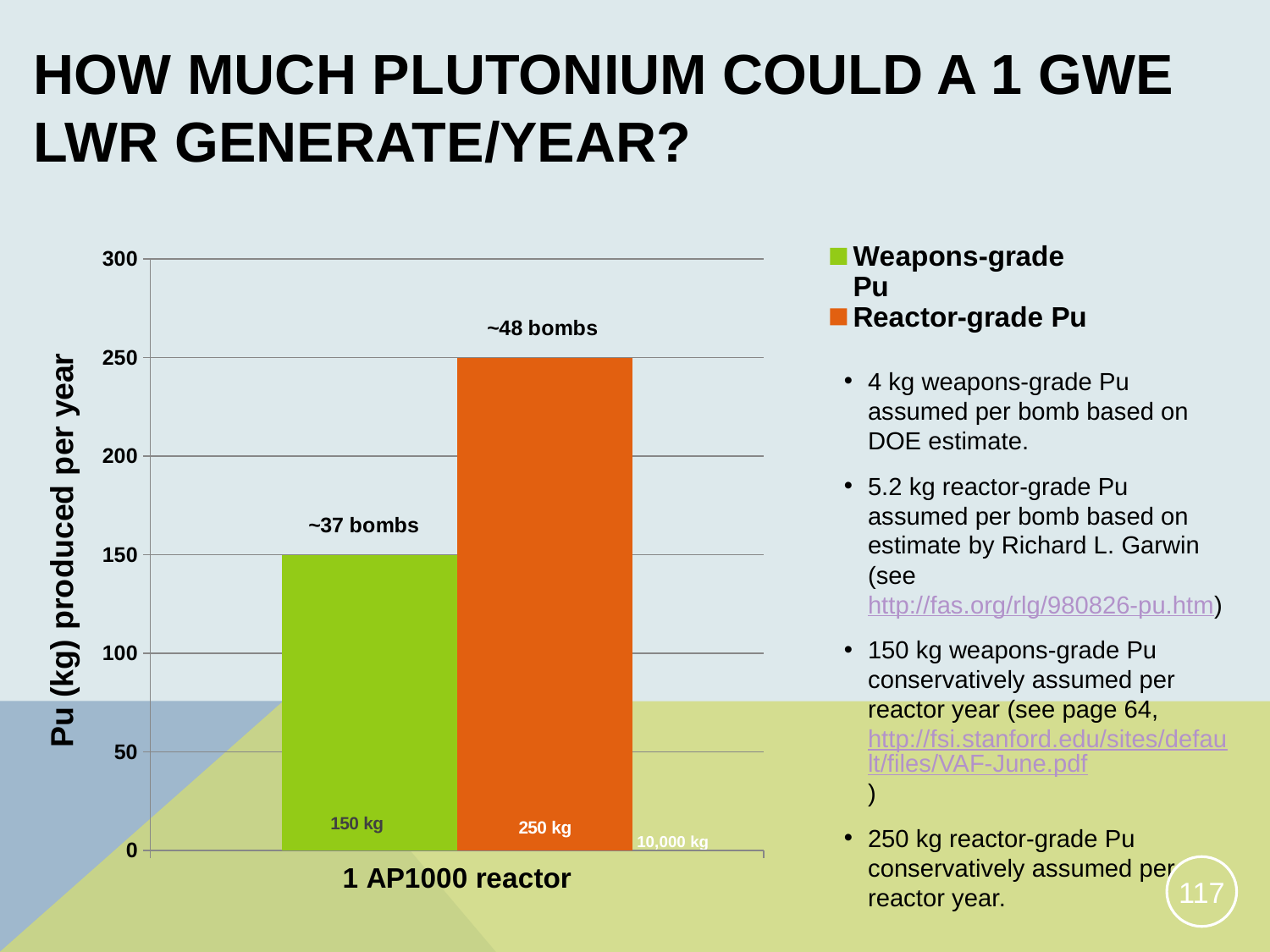
What is the label of the y axis? Pu (kg) produced per year What is the value for Weapons-grade Pu for 1 AP1000 reactor? 150 kg What is the difference between the Reactor-grade Pu value and the Weapons-grade Pu value? 100 kg What type of chart is shown on the slide? Bar chart Which series has the lowest value in the chart? Weapons-grade Pu What is the value for Reactor-grade Pu for 1 AP1000 reactor? 250 kg What colour is the bar for Reactor-grade Pu? Orange Is the value for Reactor-grade Pu greater or less than 200? greater How many series does the legend list? 2 Is the value for Weapons-grade Pu greater or less than 200? less Which series has the higher value for 1 AP1000 reactor, Weapons-grade Pu or Reactor-grade Pu? Reactor-grade Pu How many categories are shown on the x axis? 1